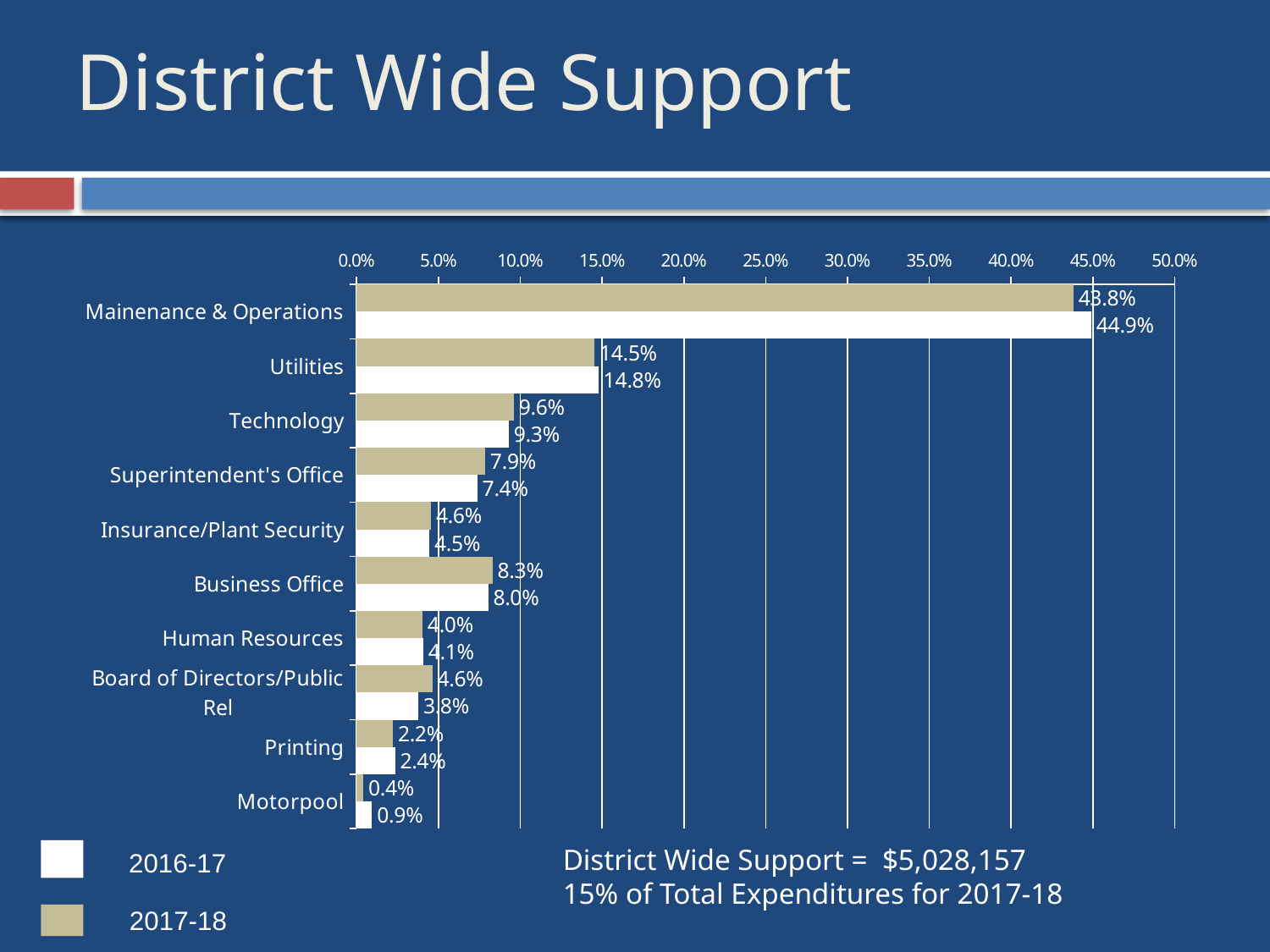
What is the 2016-17 value for Technology? 9.3% What kind of chart is shown on the slide? bar chart What is the 2016-17 value for Motorpool? 0.9% Which category has the lowest 2016-17 value? Motorpool What is the difference between the 2016-17 and 2017-18 values for Board of Directors/Public Rel? 0.8% Is the 2016-17 value for Mainenance & Operations greater or less than 40.0%? greater What is the 2017-18 value for Utilities? 14.5% Which series is shown in white in the legend? 2016-17 Which is larger for Business Office, the 2016-17 value or the 2017-18 value? 2017-18 Which category has the highest 2017-18 value? Mainenance & Operations How many series does the legend list? 2 How many categories are shown on the chart? 10